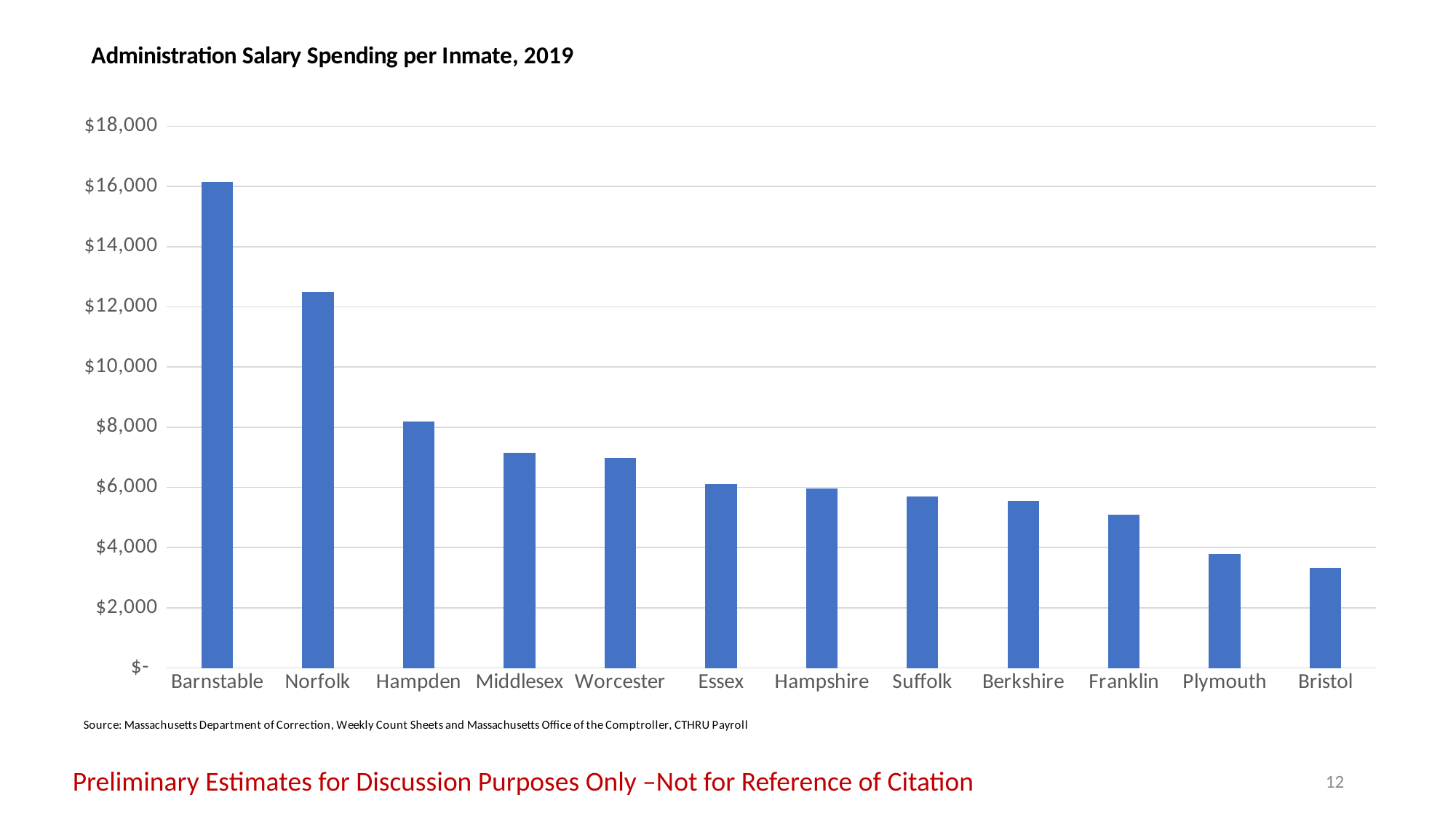
What is the title of the chart? Administration Salary Spending per Inmate, 2019 Is the value for Plymouth greater or less than $4,000? less How many counties are shown on the x axis of the chart? 12 Which county has a higher value, Franklin or Bristol? Franklin Is the value for Norfolk greater or less than $12,000? greater Is the value for Barnstable greater or less than $16,000? greater Do the values rise or fall moving from left to right along the x axis? fall What kind of chart is shown on the slide? bar chart Which county has the highest administration salary spending per inmate? Barnstable Which county has the lowest administration salary spending per inmate? Bristol Which county has a higher value, Norfolk or Hampden? Norfolk